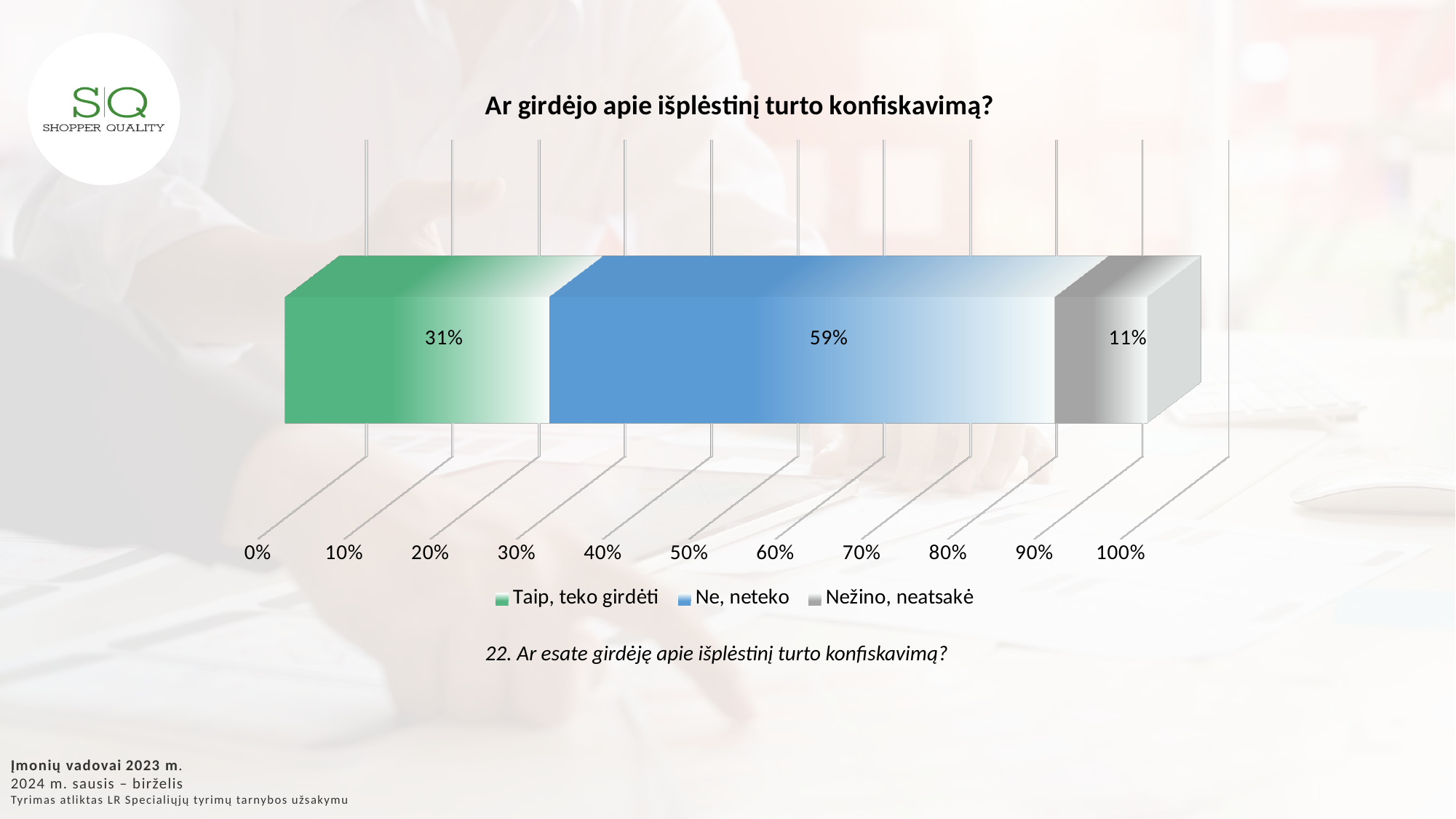
What is the value for "Taip, teko girdėti"? 31% What is the value for "Nežino, neatsakė"? 11% Which series has the highest value? Ne, neteko What is the difference between the values for "Ne, neteko" and "Taip, teko girdėti"? 28% What kind of chart is shown on the slide? Stacked bar chart How many series does the legend list? 3 Which series has the lowest value? Nežino, neatsakė Is the value for "Ne, neteko" greater or less than 50%? greater What is the value for "Ne, neteko"? 59% What is the title of the chart? Ar girdėjo apie išplėstinį turto konfiskavimą? Which is larger, the value for "Taip, teko girdėti" or the value for "Nežino, neatsakė"? Taip, teko girdėti What colour represents "Ne, neteko" in the chart? Blue